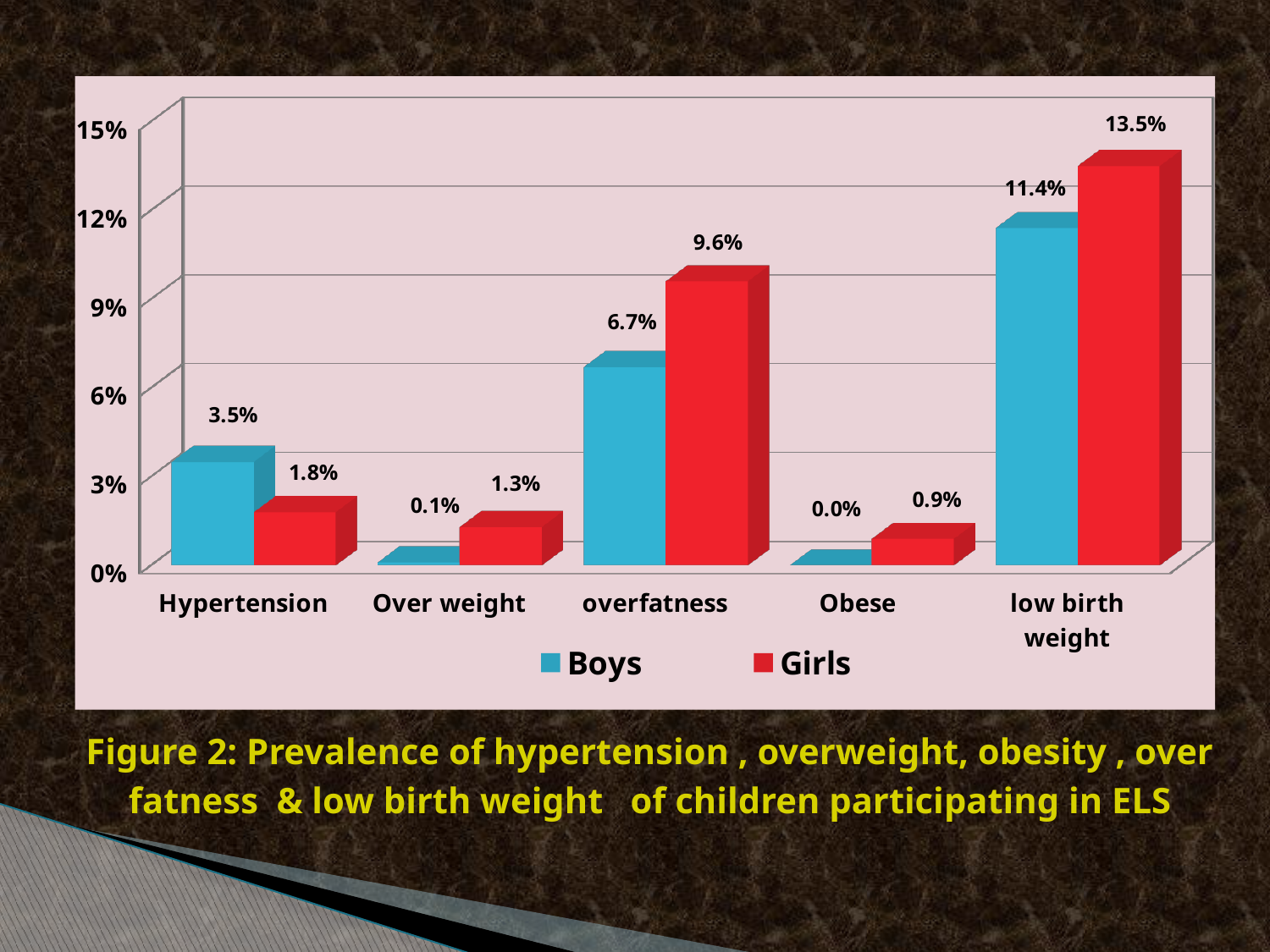
What is the value for Girls in the low birth weight category? 13.5% Which category has the highest value for Boys? low birth weight Is the value for Girls in the overfatness category greater or less than 9%? greater What is the value for Boys in the Obese category? 0.0% What is the difference between the Boys and Girls values for Hypertension? 1.7% What kind of chart is shown on the slide? bar chart Which category has the lowest value for Girls? Obese How many categories are shown on the x axis? 5 Which is larger, the Boys value or the Girls value for overfatness? Girls What is the value for Boys in the overfatness category? 6.7% What is the difference between the Girls and Boys values for low birth weight? 2.1% How many series does the legend list? 2